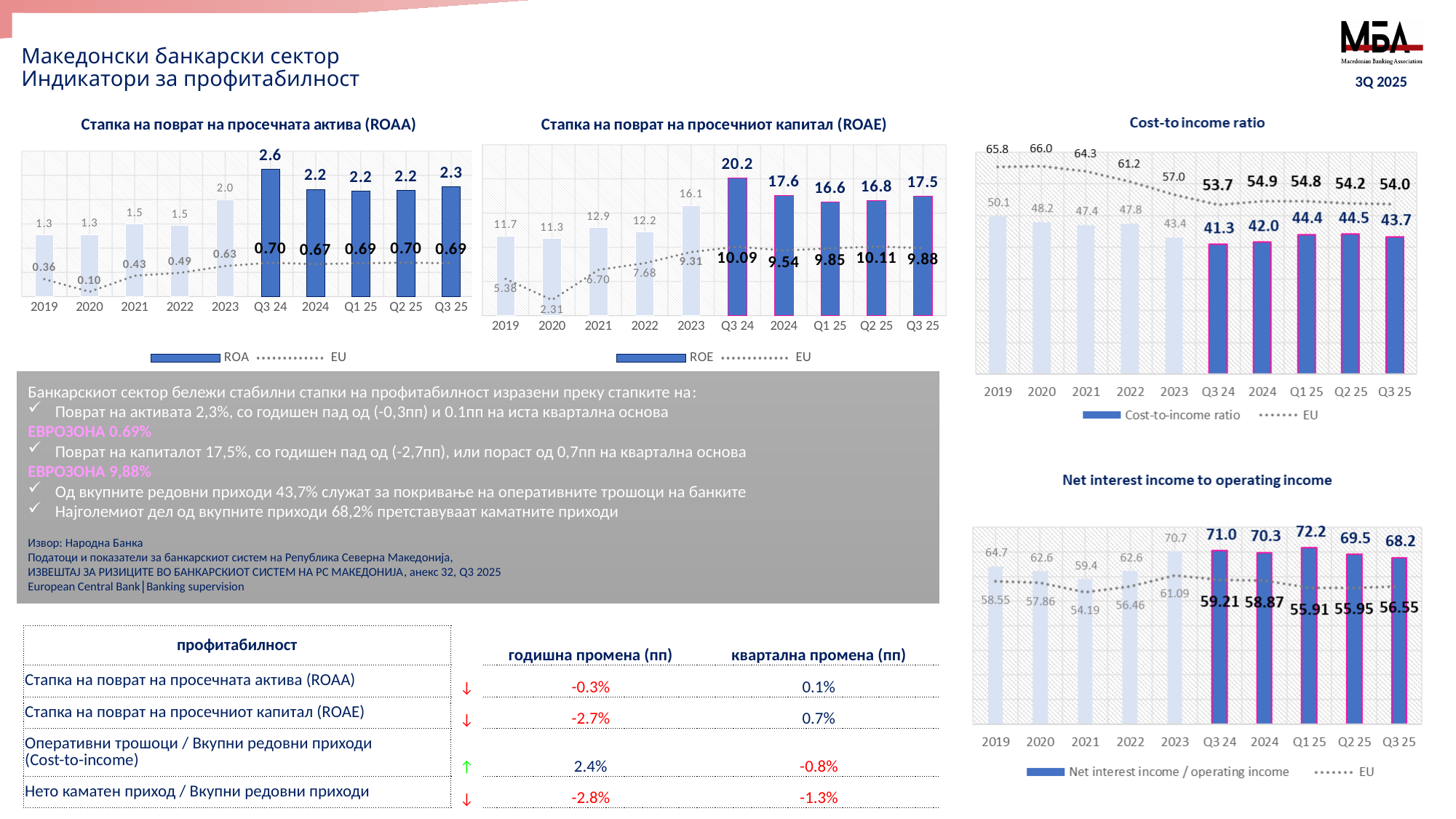
In the ROAA chart, what is the EU value for 2020? 0.10 In the ROAA chart, which period has the highest ROA bar? Q3 24 In the Cost-to income ratio chart, what is the Cost-to-income ratio value for 2019? 50.1 In the ROAE chart, what is the difference between the ROE value for Q3 24 and the ROE value for Q3 25? 2.7 In the ROAE chart, which period has the lowest EU value? 2020 In the Net interest income to operating income chart, what is the EU value for 2023? 61.09 In the Cost-to income ratio chart, which period has the lowest Cost-to-income ratio bar? Q3 24 In the Cost-to income ratio chart, which is larger for Q3 25: the Cost-to-income ratio bar or the EU value? EU In the ROAA chart (Стапка на поврат на просечната актива), what is the ROA value for Q3 25? 2.3 How many periods are shown on the x axis of the Net interest income to operating income chart? 10 In the Net interest income to operating income chart, which period has the highest bar? Q1 25 In the ROAE chart (Стапка на поврат на просечниот капитал), what is the ROE value for 2024? 17.6